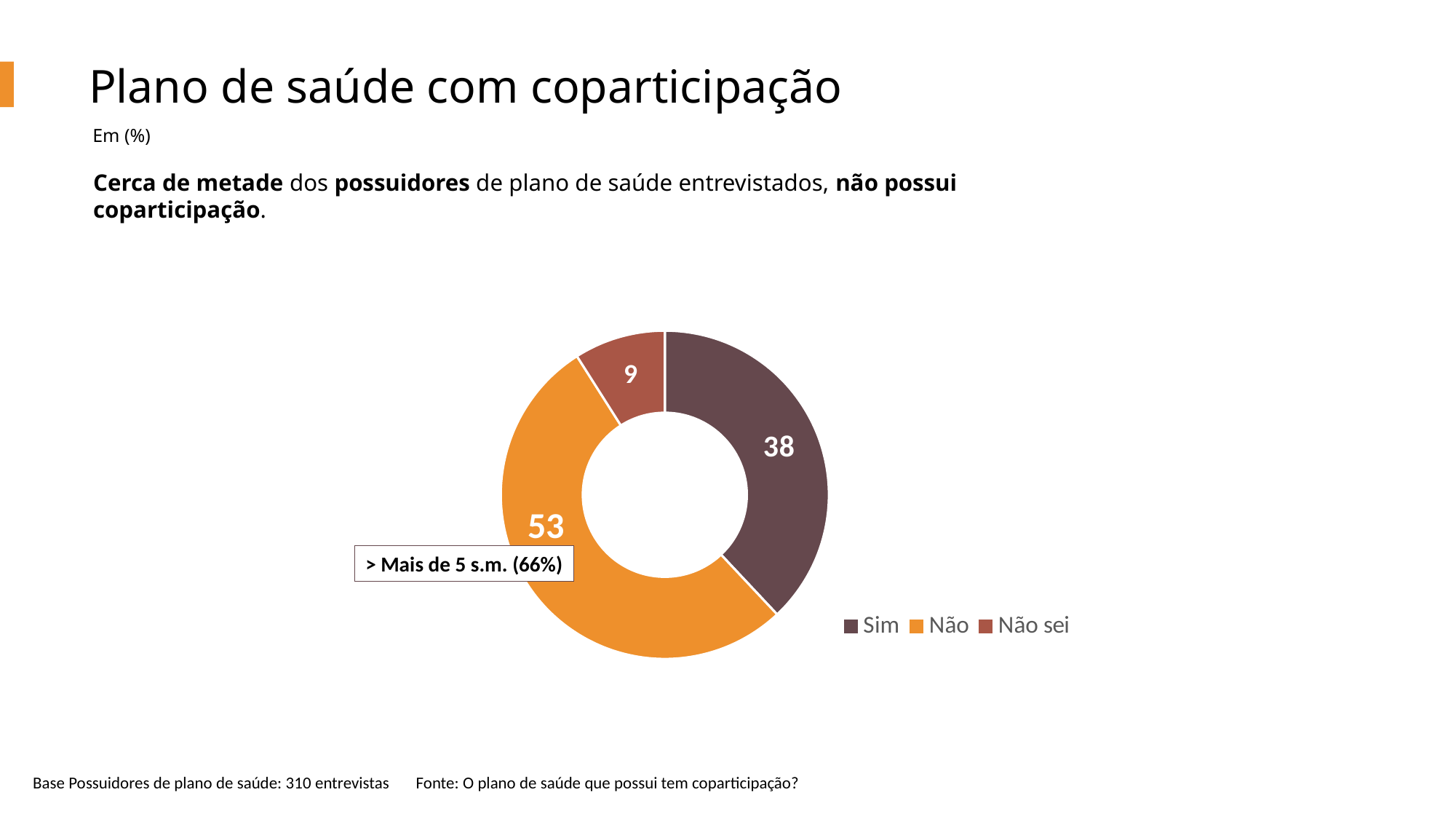
What is the total of the three values shown on the chart? 100 What is the difference between the values for "Não" and "Sim"? 15 Which category has the smallest slice? Não sei What value is shown for the "Sim" slice? 38 Which is larger, the value for "Sim" or the value for "Não sei"? Sim What value is shown for the "Não sei" slice? 9 What does the callout label next to the "Não" slice say? > Mais de 5 s.m. (66%) How many categories does the chart show? 3 What kind of chart is shown on the slide? Doughnut (pie) chart What value is shown for the "Não" slice? 53 What is the title of the slide? Plano de saúde com coparticipação Which category has the largest slice? Não